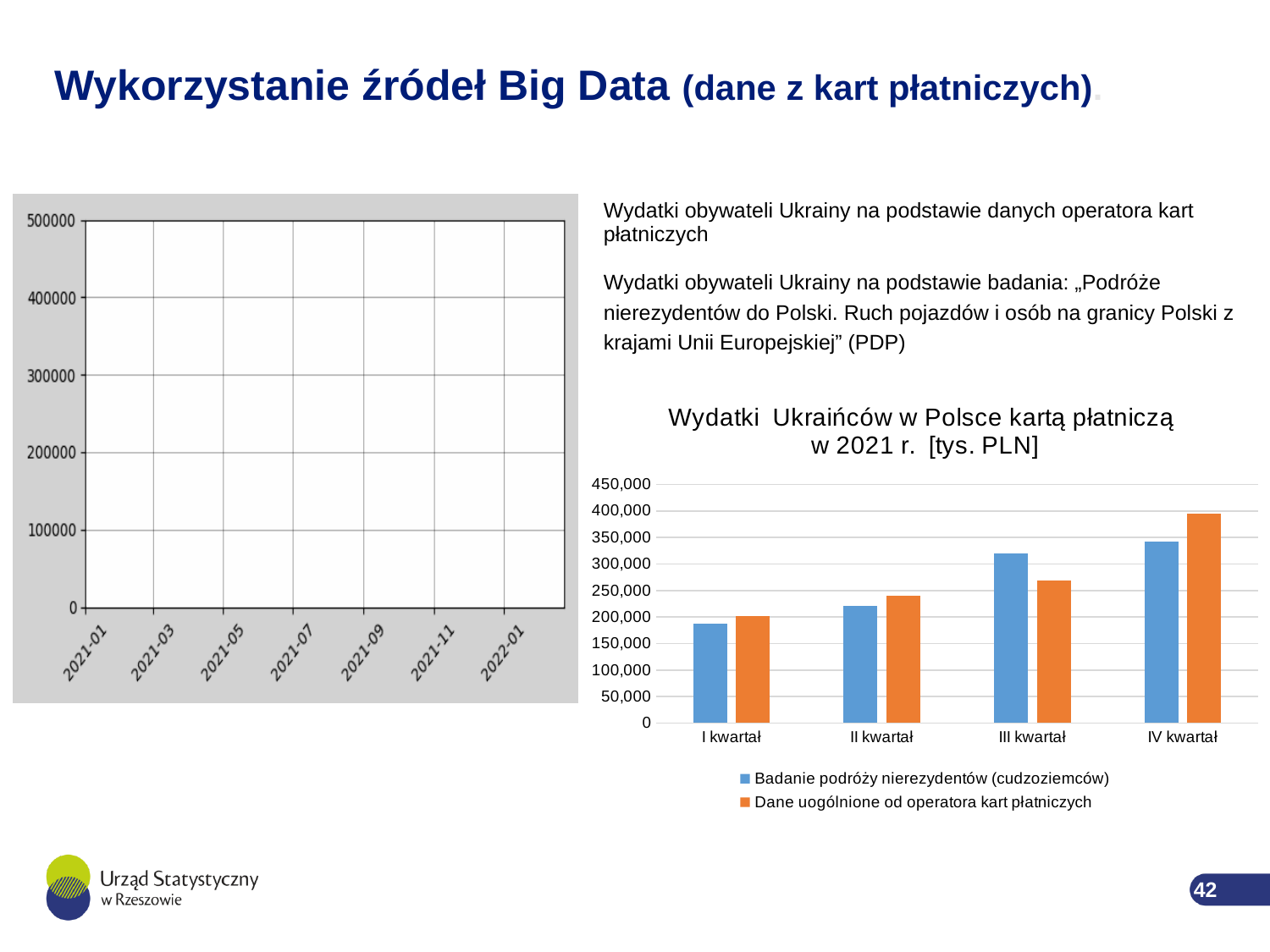
In the chart "Wydatki Ukraińców w Polsce kartą płatniczą w 2021 r.", is the value for "Dane uogólnione od operatora kart płatniczych" in IV kwartał greater or less than 350,000? greater In the chart "Wydatki Ukraińców w Polsce kartą płatniczą w 2021 r.", is the value for "Badanie podróży nierezydentów (cudzoziemców)" in I kwartał greater or less than 200,000? less What kind of chart is the chart titled "Wydatki Ukraińców w Polsce kartą płatniczą w 2021 r. [tys. PLN]"? bar chart In the chart "Wydatki Ukraińców w Polsce kartą płatniczą w 2021 r.", do the values for "Badanie podróży nierezydentów (cudzoziemców)" rise or fall from I kwartał to IV kwartał? rise In the chart "Wydatki Ukraińców w Polsce kartą płatniczą w 2021 r.", in IV kwartał, which series has the larger value: "Badanie podróży nierezydentów (cudzoziemców)" or "Dane uogólnione od operatora kart płatniczych"? Dane uogólnione od operatora kart płatniczych In the chart "Wydatki Ukraińców w Polsce kartą płatniczą w 2021 r.", which quarter has the lowest value for "Badanie podróży nierezydentów (cudzoziemców)"? I kwartał In the chart "Wydatki Ukraińców w Polsce kartą płatniczą w 2021 r.", how many series does the legend list? 2 In the chart "Wydatki Ukraińców w Polsce kartą płatniczą w 2021 r.", in III kwartał, which series has the larger value: "Badanie podróży nierezydentów (cudzoziemców)" or "Dane uogólnione od operatora kart płatniczych"? Badanie podróży nierezydentów (cudzoziemców) In the chart "Wydatki Ukraińców w Polsce kartą płatniczą w 2021 r.", how many quarters are shown on the x axis? 4 In the chart "Wydatki Ukraińców w Polsce kartą płatniczą w 2021 r.", what colour are the bars for "Dane uogólnione od operatora kart płatniczych"? orange In the chart "Wydatki Ukraińców w Polsce kartą płatniczą w 2021 r.", is the value for "Badanie podróży nierezydentów (cudzoziemców)" in III kwartał greater or less than 300,000? greater In the chart "Wydatki Ukraińców w Polsce kartą płatniczą w 2021 r.", which quarter has the highest value for "Dane uogólnione od operatora kart płatniczych"? IV kwartał